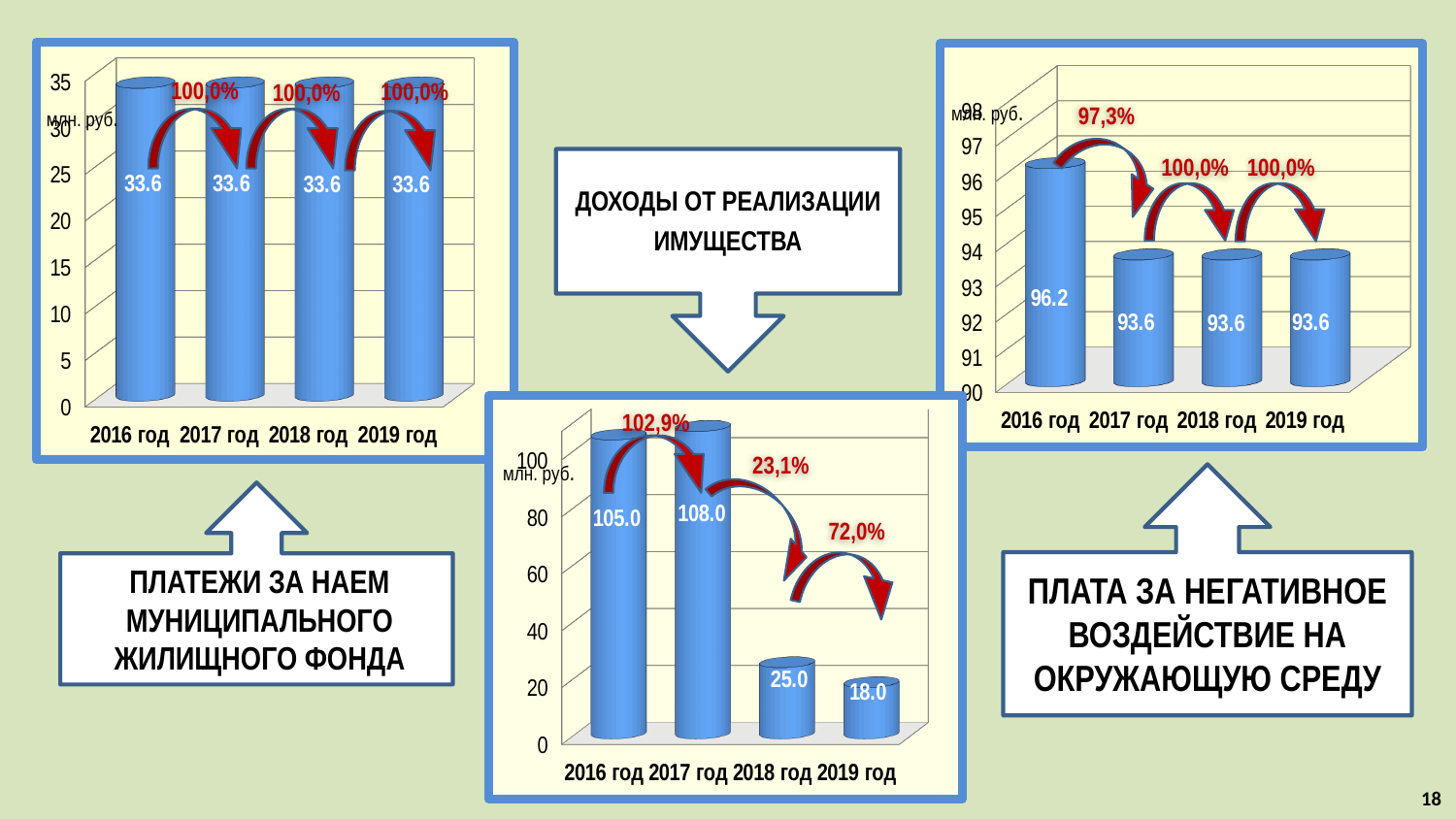
In the bottom-centre chart (income from sale of property), what is the difference between the values for 2017 год and 2018 год? 83.0 In the top-left chart (payments for rental of municipal housing), what is the value for 2018 год? 33.6 In the top-right chart (payment for negative environmental impact), which is larger, the value for 2016 год or 2018 год? 2016 год How many years are shown on the x axis of the top-left chart (payments for rental of municipal housing)? 4 In the top-right chart (payment for negative environmental impact), what is the difference between the values for 2016 год and 2017 год? 2.6 In the bottom-centre chart (income from sale of property), which year has the lowest value? 2019 год In the bottom-centre chart (income from sale of property), which year has the highest value? 2017 год In the bottom-centre chart (income from sale of property), what is the value for 2017 год? 108.0 In the bottom-centre chart (income from sale of property), do the values rise or fall from 2017 год to 2019 год? fall In the bottom-centre chart (income from sale of property), what is the value for 2019 год? 18.0 What type of chart is the top-left chart (payments for rental of municipal housing)? bar chart In the top-right chart (payment for negative environmental impact), what is the value for 2016 год? 96.2